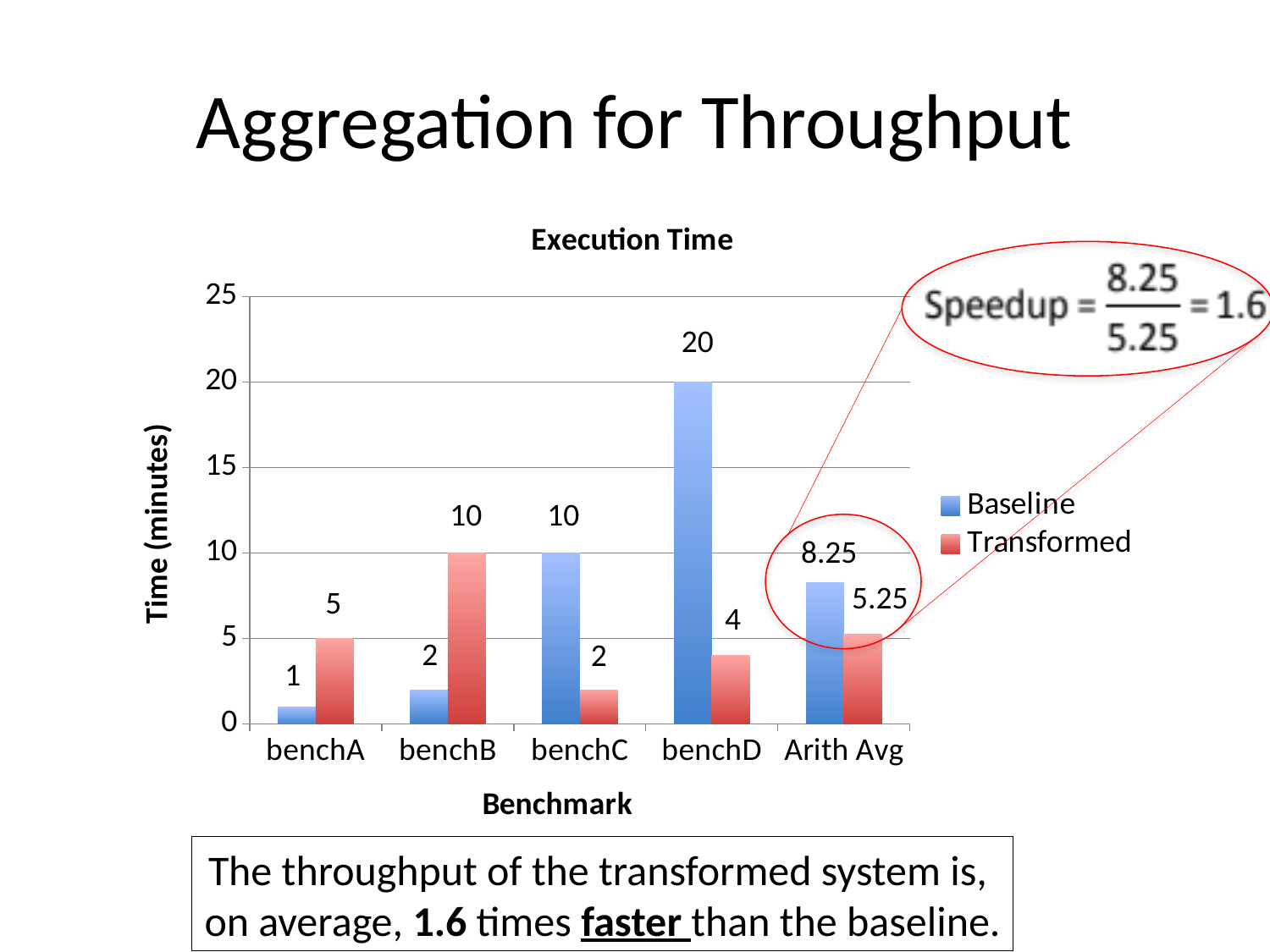
How many benchmark categories are shown on the x axis? 5 What is the Transformed execution time for benchB? 10 What is the title of the chart? Execution Time Which benchmark has the highest Baseline execution time? benchD What is the difference between the Baseline and Transformed values for benchD? 16 What kind of chart is shown? bar chart Which benchmark has the lowest Baseline execution time? benchA How many series does the legend list? 2 What is the Transformed value for Arith Avg? 5.25 For benchA, which is larger: the Baseline or the Transformed value? Transformed What is the Baseline execution time for benchD? 20 What is the Baseline value for Arith Avg? 8.25